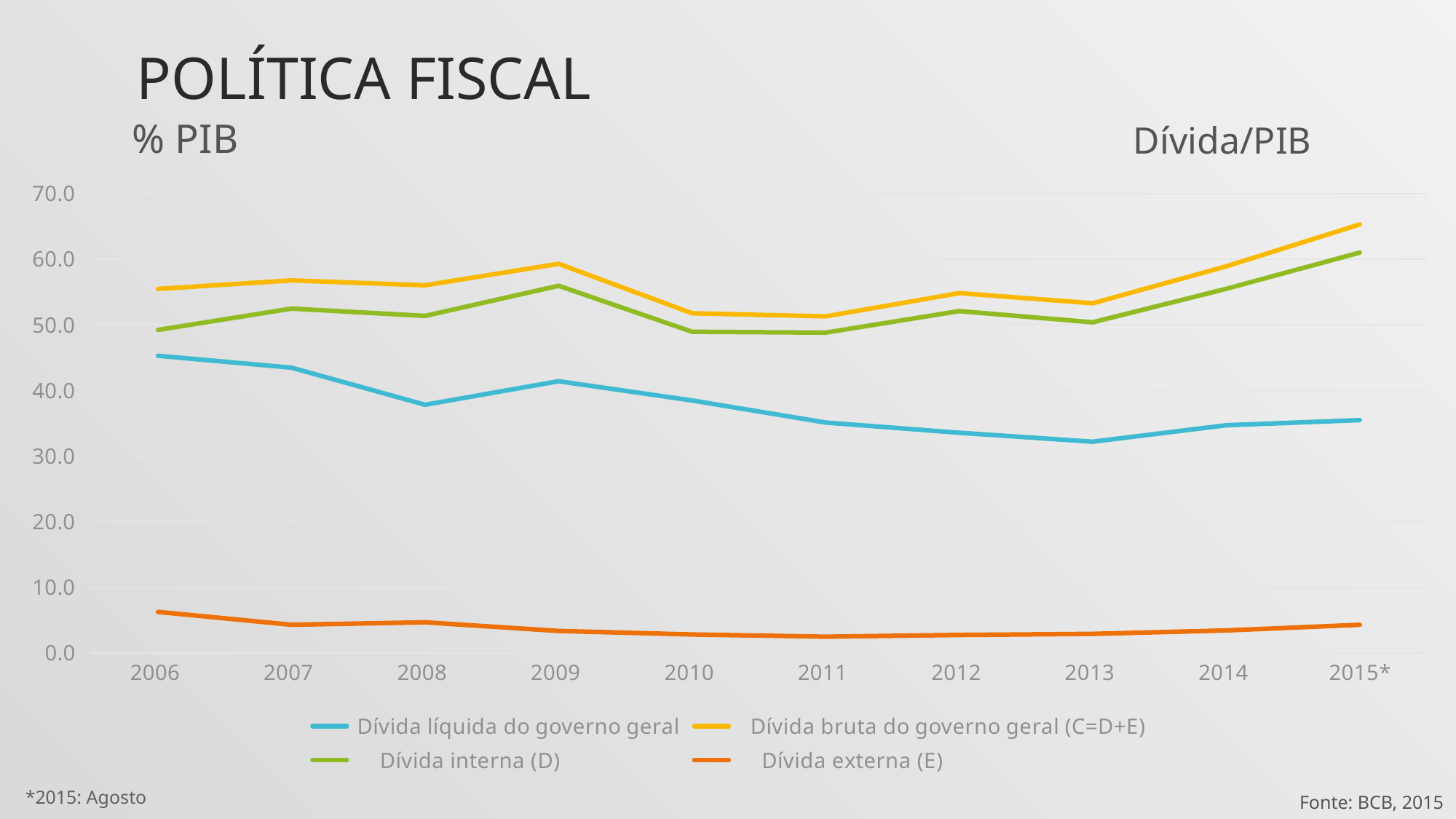
What colour is the line for Dívida externa (E)? orange Is the value for Dívida líquida do governo geral in 2006 greater or less than 40.0? greater Which is larger for Dívida interna (D): the value in 2009 or the value in 2010? 2009 Does Dívida líquida do governo geral rise or fall from 2006 to 2013? fall How many years are shown along the x axis? 10 In which year is Dívida bruta do governo geral (C=D+E) highest? 2015* Is the value for Dívida líquida do governo geral in 2013 greater or less than 35.0? less In which year is Dívida líquida do governo geral lowest? 2013 What kind of chart is shown on the slide? line chart Is the value for Dívida externa (E) in 2006 greater or less than 10.0? less How many series does the legend list? 4